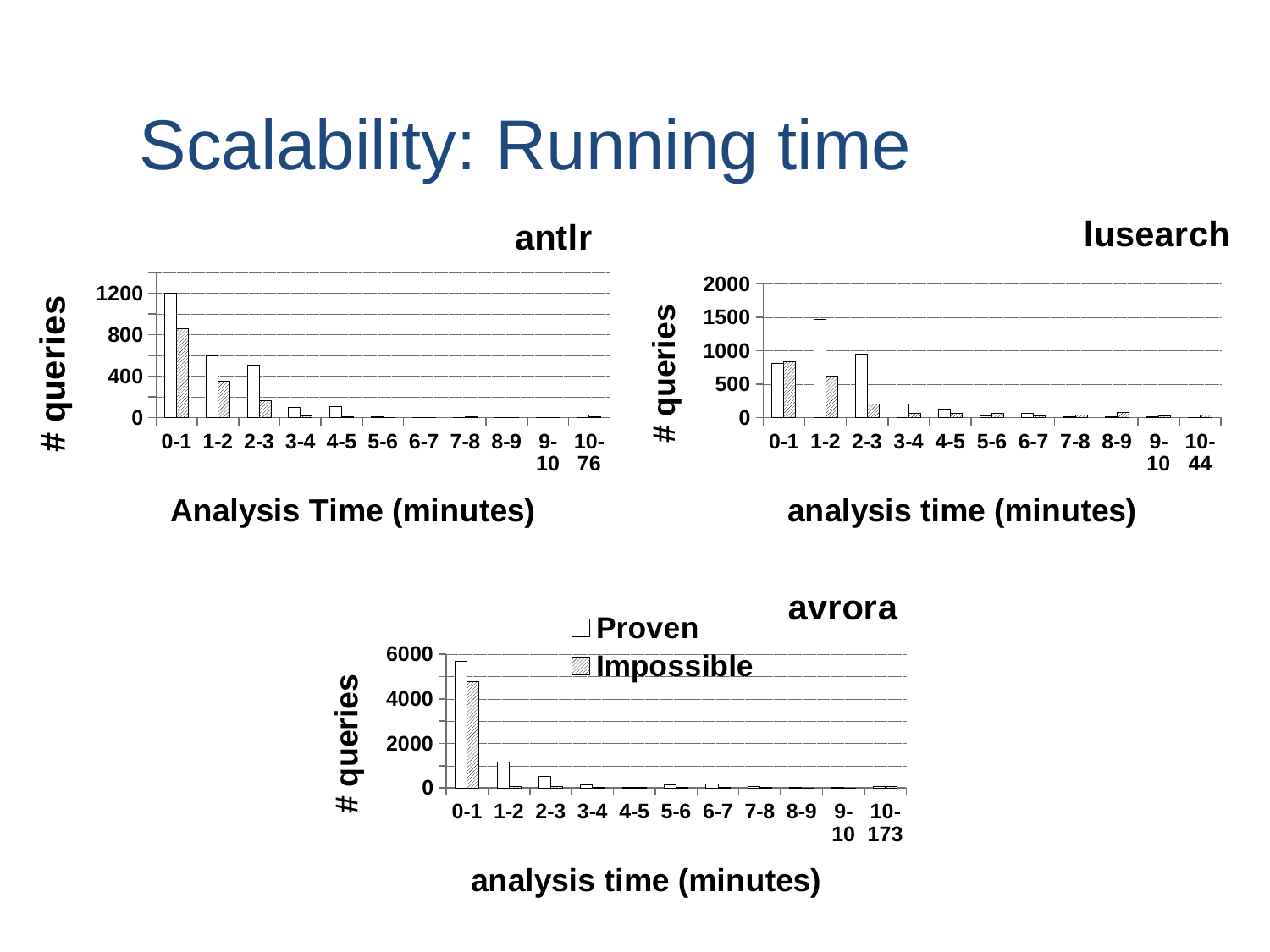
In the antlr chart, is the Proven value for 1-2 greater or less than 400? greater In the avrora chart, which analysis-time category has the highest Impossible bar? 0-1 In the lusearch chart, which is larger, the Proven value for 0-1 or the Proven value for 1-2? 1-2 How many analysis-time categories are shown on the x axis of the lusearch chart? 11 What are the two series named in the legend on the avrora chart? Proven and Impossible In the antlr chart, which analysis-time category has the highest Proven bar? 0-1 What kind of chart is the antlr chart? bar chart In the lusearch chart, which analysis-time category has the highest Proven bar? 1-2 In the avrora chart, is the Proven value for 0-1 greater or less than 4000? greater In the avrora chart, do the Proven values generally rise or fall as analysis time increases from 0-1 to 3-4? fall How many series does the legend on the avrora chart list? 2 In the lusearch chart, is the Proven value for 1-2 greater or less than 1000? greater